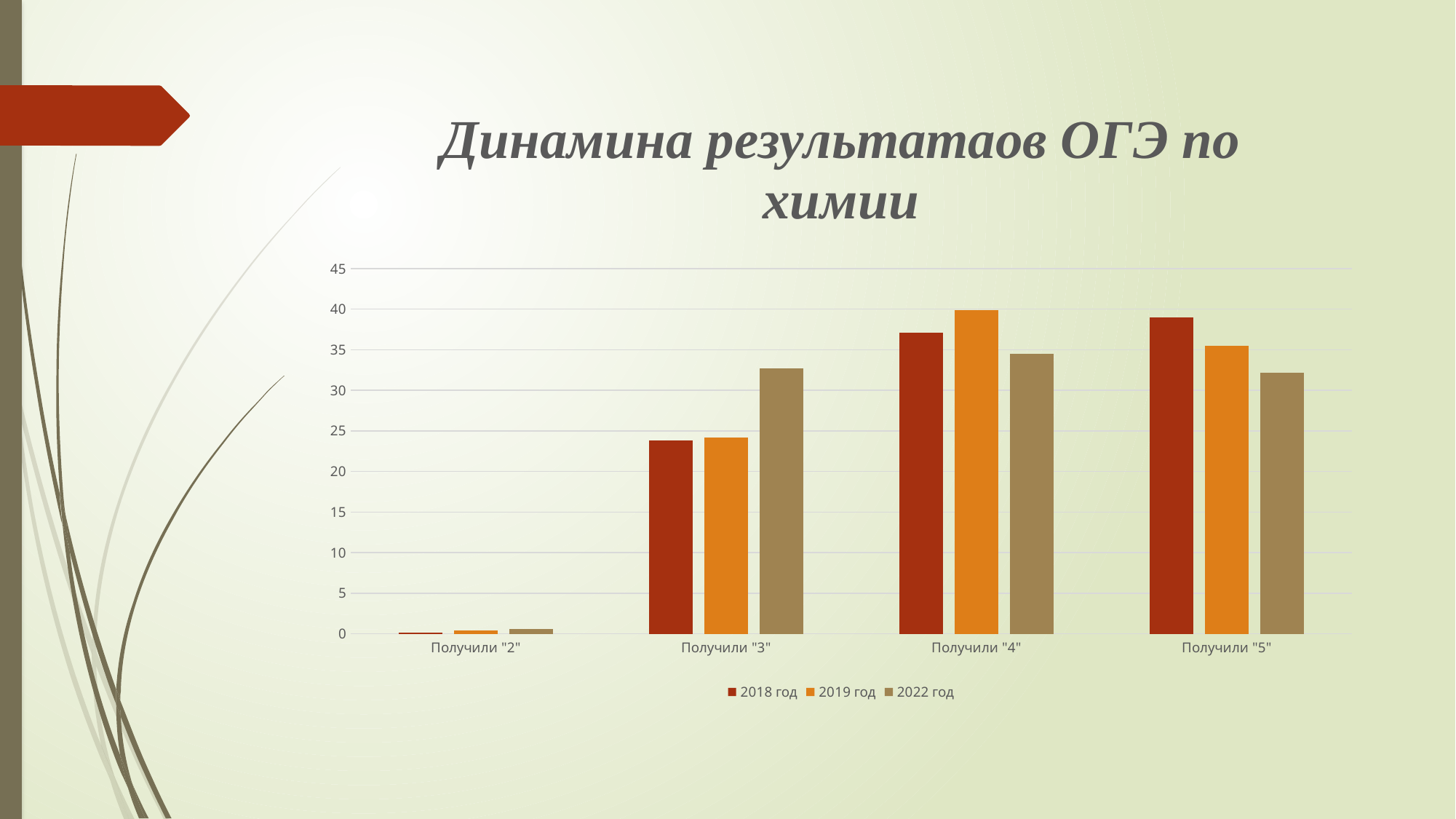
What is the title of the chart on the slide? Динамина результатаов ОГЭ по химии Is the value for 2022 год in the category Получили "5" greater or less than 35? less In the category Получили "5", which is larger: the value for 2018 год or for 2022 год? 2018 год How many categories are shown on the x axis? 4 Which category has the lowest value for the 2018 год series? Получили "2" Is the value for 2019 год in the category Получили "4" greater or less than 35? greater In the category Получили "4", which series has the highest bar? 2019 год Is the value for 2022 год in the category Получили "3" greater or less than 30? greater Which category has the highest value for the 2022 год series? Получили "4" How many series does the legend list? 3 What kind of chart is shown on the slide? bar chart